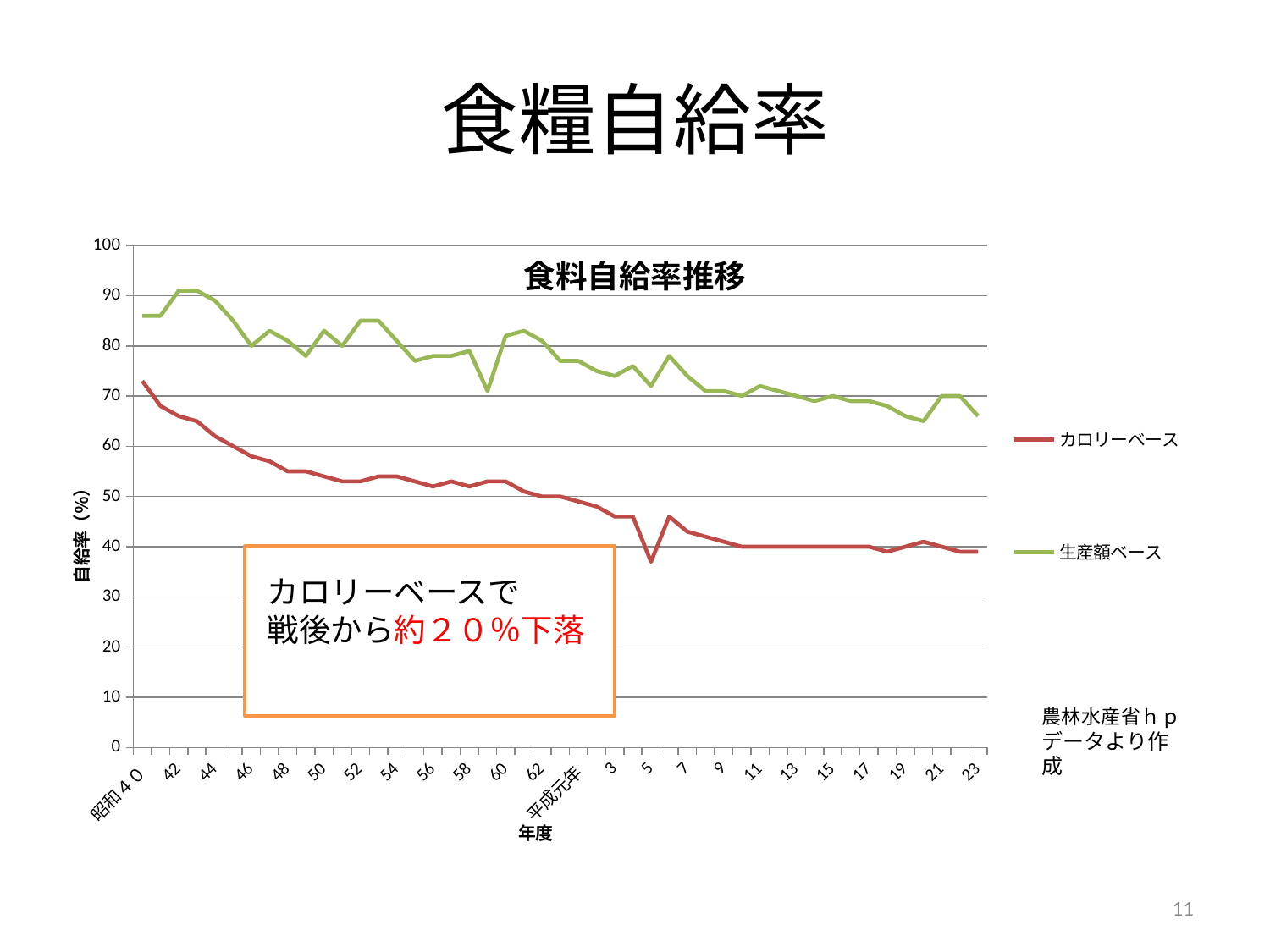
Is the 生産額ベース value at 平成23 greater or less than 70? less Is the カロリーベース value at 平成23 greater or less than 50? less Does the カロリーベース series rise or fall overall from 昭和40 to 平成23? fall For the カロリーベース series, which is larger, the value at 昭和40 or the value at 平成23? 昭和40 Is the カロリーベース value at 昭和40 greater or less than 70? greater What kind of chart is shown on the slide? line chart At 昭和40, which series has the higher value, カロリーベース or 生産額ベース? 生産額ベース Does the 生産額ベース series rise or fall overall from 昭和40 to 平成23? fall What colour is the カロリーベース line in the chart? red What is the title of the chart? 食料自給率推移 How many series does the legend of the chart list? 2